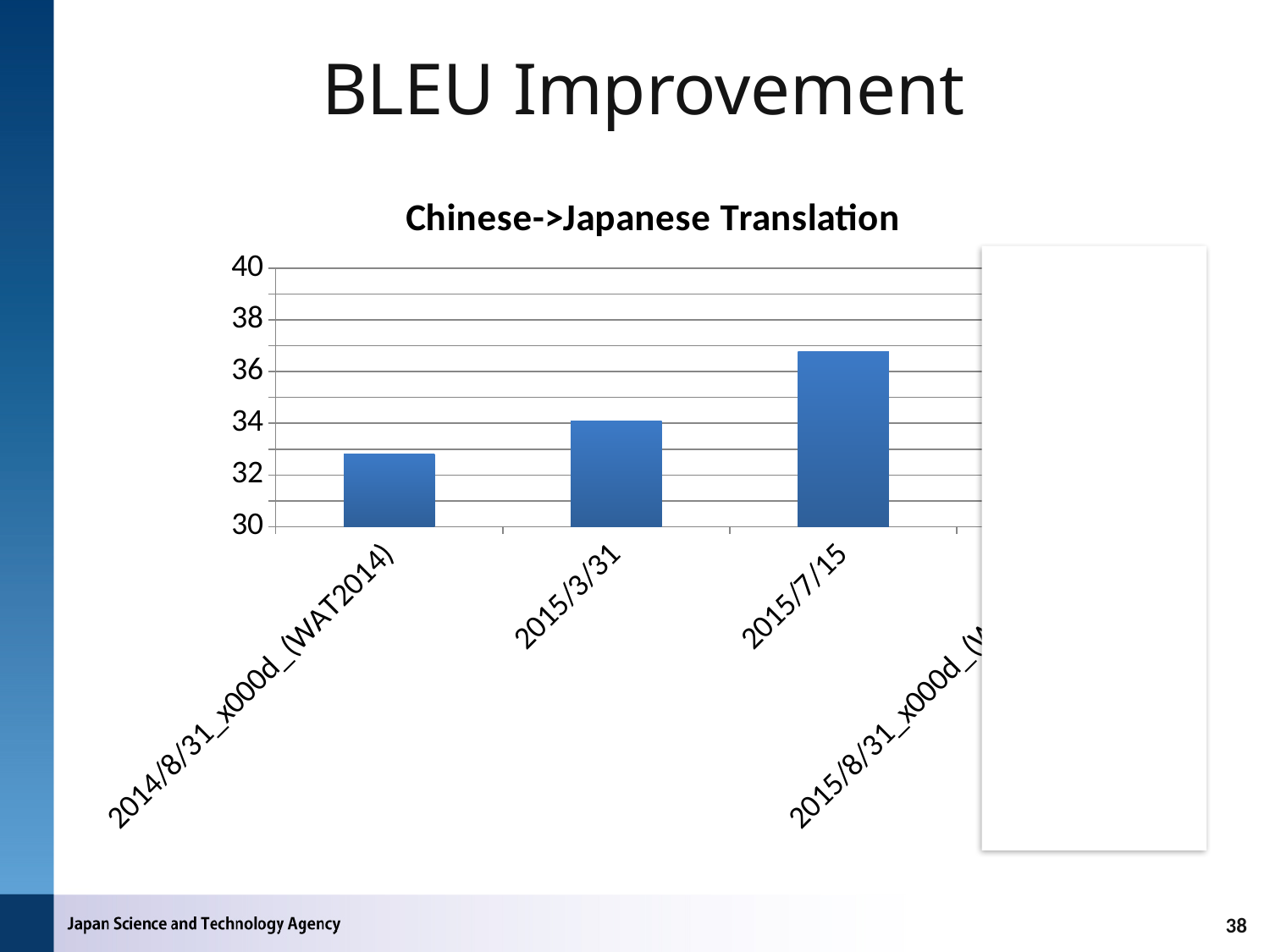
Is the value for 2014/8/31 (WAT2014) greater or less than 32? greater Do the values rise or fall from 2014/8/31 (WAT2014) to 2015/7/15? rise Which is larger, the value for 2015/3/31 or the value for 2015/7/15? 2015/7/15 Is the value for 2015/7/15 greater or less than 38? less Is the value for 2015/3/31 greater or less than 36? less Among the bars visible on the slide, which category has the highest value? 2015/7/15 What is the title of the chart? Chinese->Japanese Translation Which is larger, the value for 2014/8/31 (WAT2014) or the value for 2015/3/31? 2015/3/31 What kind of chart is shown on the slide? bar chart